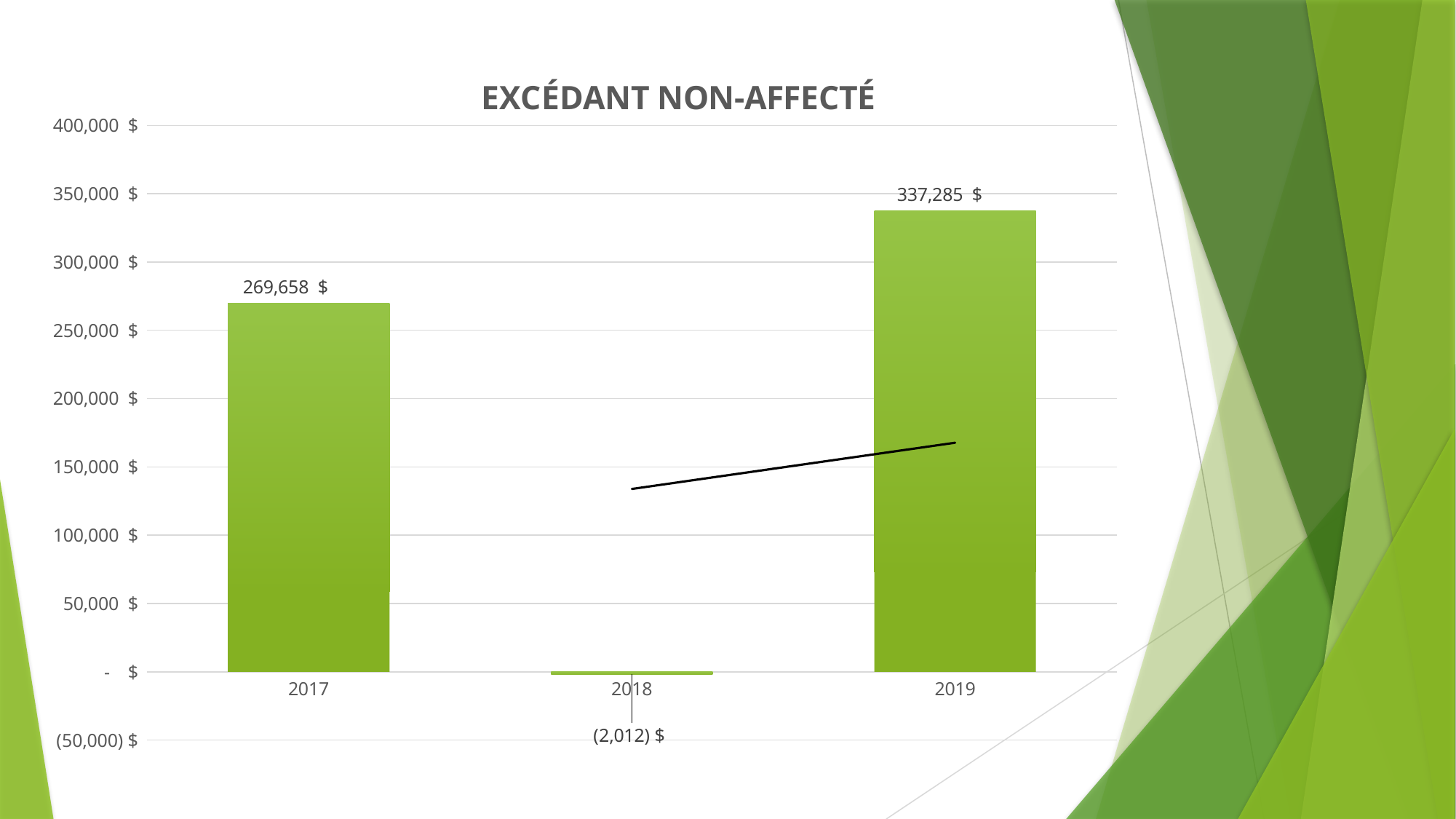
What is the value for 2019? 337,285 $ What kind of chart is this? bar chart How many years are shown on the x axis? 3 What is the value for 2017? 269,658 $ Is the value for 2017 greater or less than 250,000 $? greater What is the value for 2018? (2,012) $ Which year has the highest value? 2019 What is the difference between the values for 2019 and 2017? 67,627 $ Is the value for 2019 greater or less than 300,000 $? greater What is the title of the chart? EXCÉDANT NON-AFFECTÉ Which is larger, the value for 2017 or the value for 2019? 2019 Which year has the lowest value? 2018